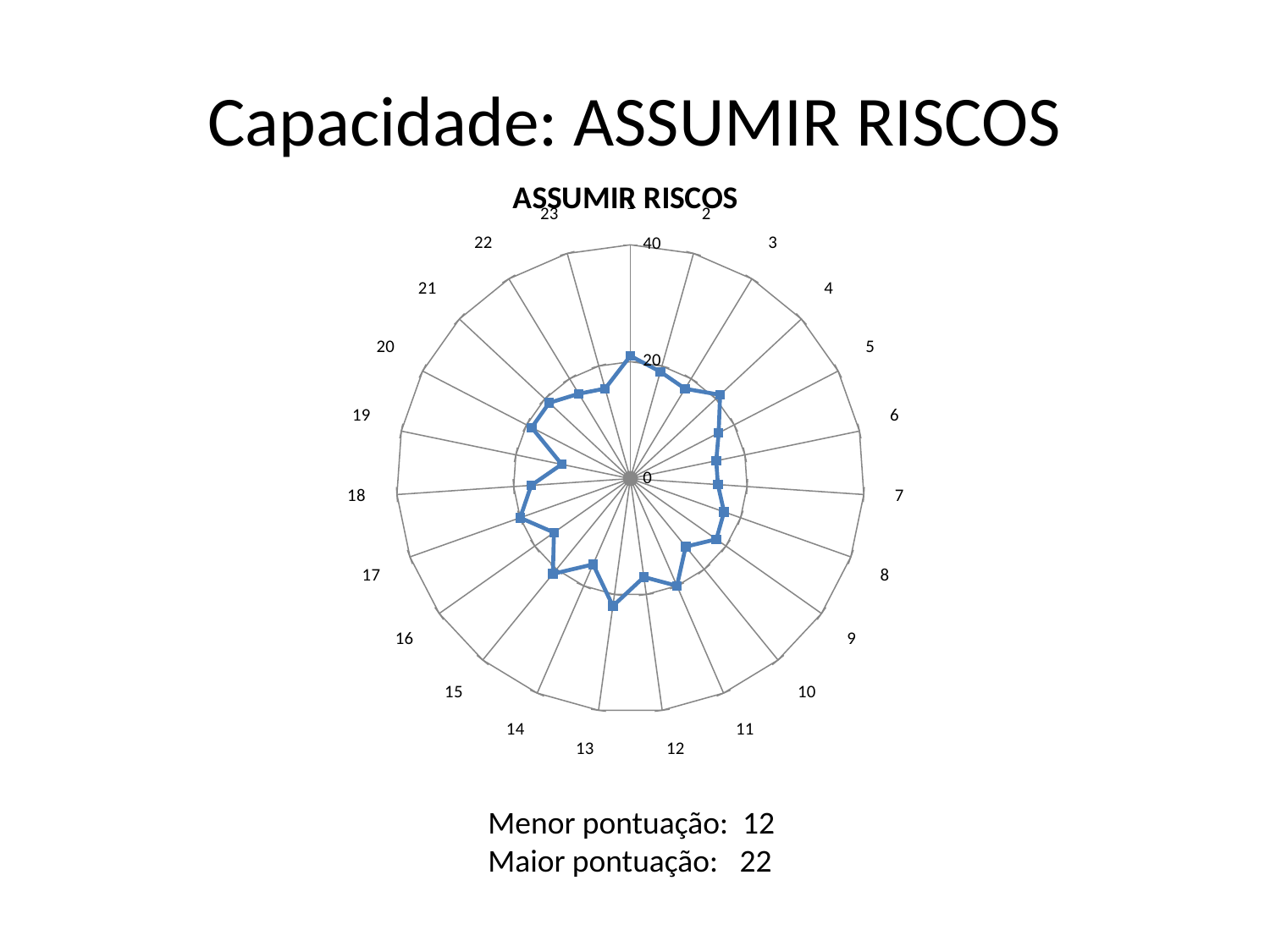
How many categories (spokes) does the radar chart have? 23 What is the maximum value shown on the chart's radial axis? 40 Which has the larger value, category 13 or category 19? 13 What is the highest score (Maior pontuação) shown on the slide? 22 Is the value for category 13 greater or less than 20? greater What is the lowest score (Menor pontuação) shown on the slide? 12 Which category has the lowest value on the radar chart? 19 What is the title of the chart? ASSUMIR RISCOS What type of chart is shown on the slide? Radar chart Is the value for category 19 greater or less than 20? less Is the value for category 6 greater or less than 20? less